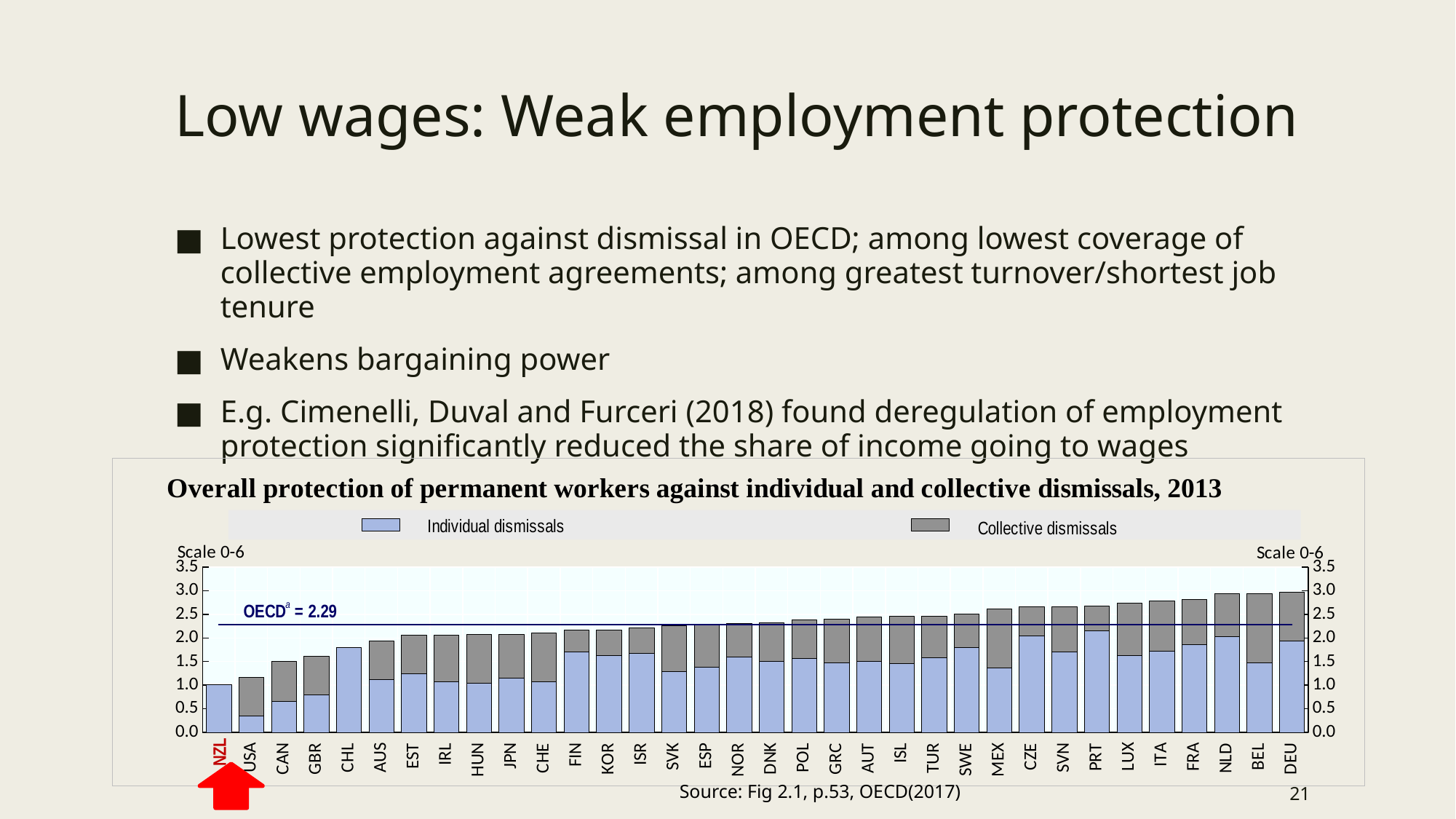
What kind of chart is shown on the slide? Stacked bar chart Do the total values rise or fall moving from left to right along the x axis? Rise Which has a higher total value, CAN or CHL? CHL Which country has the lowest overall protection score in the chart? NZL How many countries are shown on the x axis of the chart? 34 Is the total value for DEU greater or less than 2.5? greater Is the total value for NZL greater or less than 1.5? less What is the OECD average value marked by the horizontal line on the chart? 2.29 What are the two series named in the chart legend? Individual dismissals and Collective dismissals How many series does the chart legend list? 2 Is the total value for CHL greater or less than 2.0? less What is the title of the chart? Overall protection of permanent workers against individual and collective dismissals, 2013